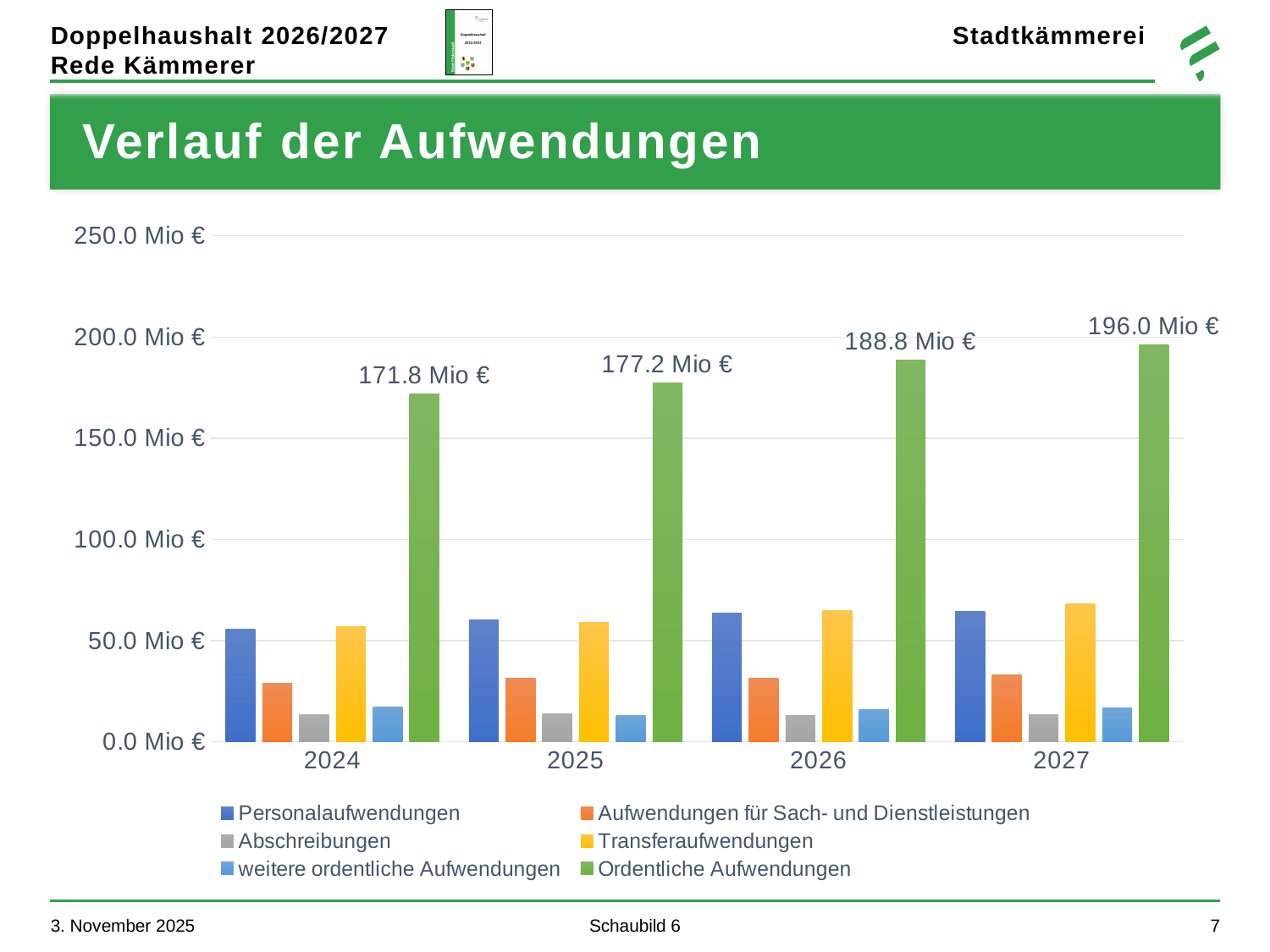
Do the Ordentliche Aufwendungen rise or fall from 2024 to 2027? rise Which year has higher Ordentliche Aufwendungen, 2025 or 2026? 2026 What is the difference in Ordentliche Aufwendungen between 2027 and 2024? 24.2 Mio € In which year are the Ordentliche Aufwendungen lowest? 2024 In which year are the Ordentliche Aufwendungen highest? 2027 Is the value for Abschreibungen in 2024 greater or less than 50.0 Mio €? less How many years are shown on the x axis? 4 What is the value of Ordentliche Aufwendungen for 2024? 171.8 Mio € Is the value for Transferaufwendungen in 2027 greater or less than 50.0 Mio €? greater How many series does the legend list? 6 What is the value of Ordentliche Aufwendungen for 2027? 196.0 Mio € What kind of chart is shown on the slide? bar chart